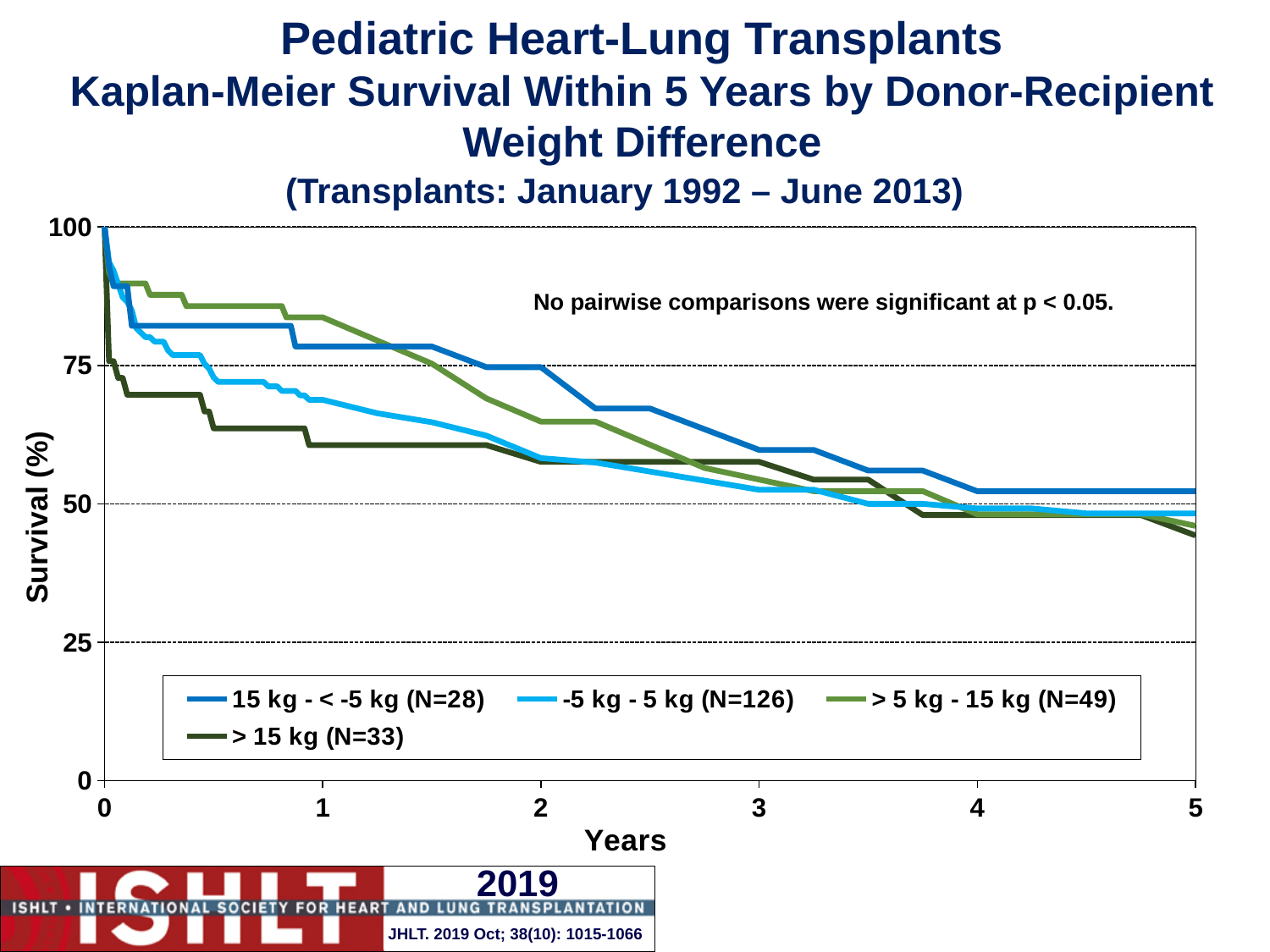
What kind of chart is shown on the slide? Line chart At 1 year, which group has the lowest survival? > 15 kg (N=33) At 1 year, is the survival value for the > 5 kg - 15 kg group greater or less than 75? greater Do the survival curves rise or fall as years increase? Fall At 3 years, which has higher survival: the 15 kg - < -5 kg group or the -5 kg - 5 kg group? 15 kg - < -5 kg (N=28) What is the label of the y axis? Survival (%) At 1 year, is the survival value for the > 15 kg group greater or less than 75? less According to the legend, how many patients are in the -5 kg - 5 kg group? N=126 How many series does the legend list? 4 At 3 years, is the survival value for the 15 kg - < -5 kg group greater or less than 50? greater At 1 year, which group has the highest survival? > 5 kg - 15 kg (N=49)